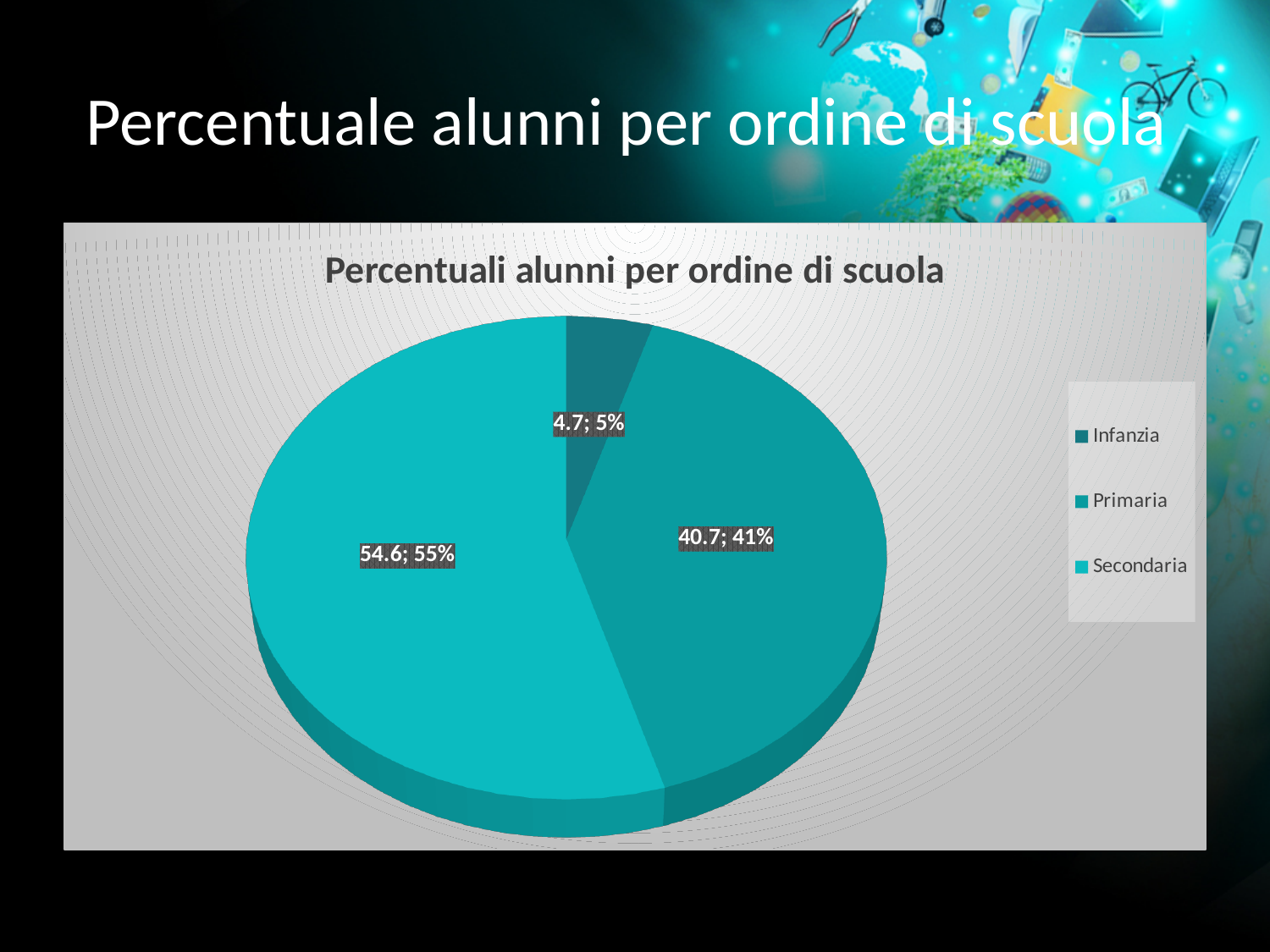
What is the difference between the Secondaria value (54.6) and the Primaria value (40.7)? 13.9 What percentage share of the pie does Infanzia have? 5% What is the title of the chart? Percentuali alunni per ordine di scuola What value is labelled on the Primaria slice? 40.7; 41% What kind of chart is shown on the slide? Pie chart Which is larger, the Primaria slice or the Secondaria slice? Secondaria What value is labelled on the Secondaria slice? 54.6; 55% What percentage share of the pie does Secondaria have? 55% Which category has the largest slice of the pie? Secondaria What value is labelled on the Infanzia slice? 4.7; 5% Which category has the smallest slice of the pie? Infanzia How many categories does the legend list? 3